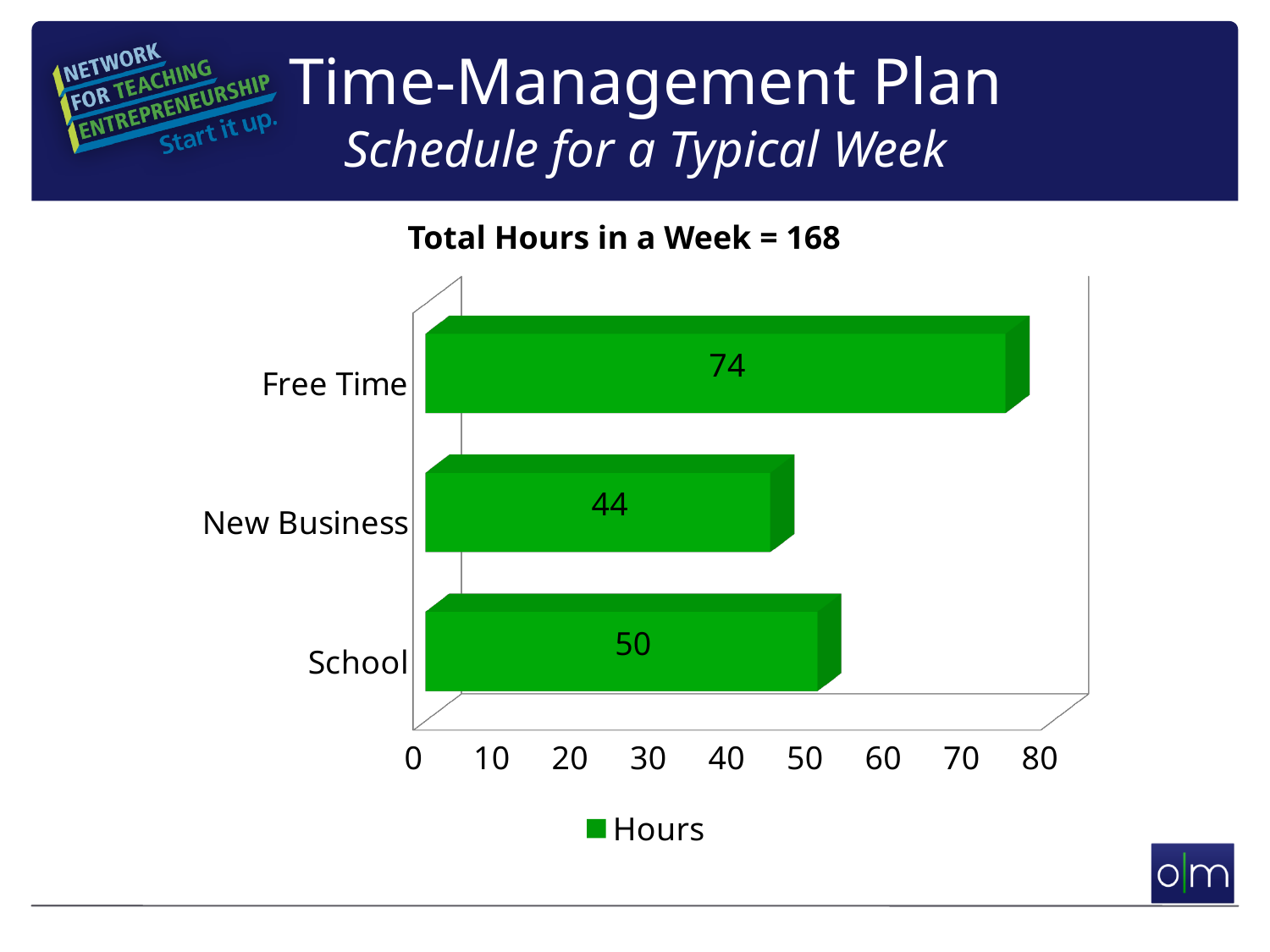
What kind of chart is shown on the slide? Bar chart Which category has the lowest value? New Business Which is larger, the value for School or the value for New Business? School How many series does the legend list? 1 What is the value for Free Time? 74 What is the value for School? 50 How many categories are shown in the chart? 3 What is the value for New Business? 44 What is the difference between the values for Free Time and School? 24 Which category has the highest value? Free Time What is the difference between the values for School and New Business? 6 Is the value for Free Time greater or less than 70? greater